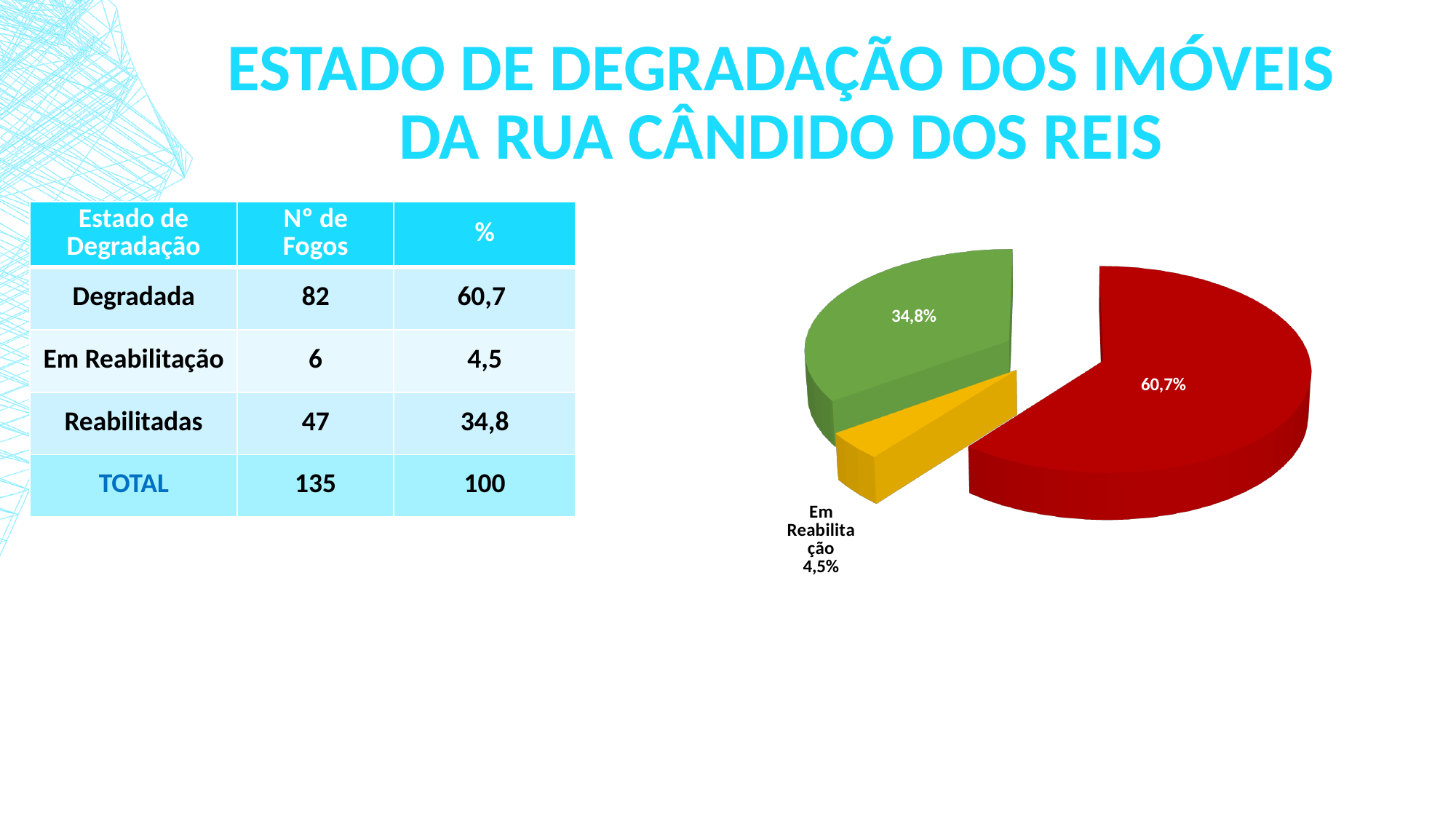
What colour is the Em Reabilitação slice in the pie chart? yellow Which is larger in the pie chart, the green slice or the Em Reabilitação slice? the green slice How many slices does the pie chart have? 3 What percentage is shown on the green slice of the pie chart? 34,8% What is the difference in percentage points between the green slice and the Em Reabilitação slice? 30,3 Which slice of the pie chart is the largest? the red slice (60,7%) What kind of chart is shown on the slide? pie chart Which slice of the pie chart is labelled with a category name on the chart itself? Em Reabilitação What is the difference in percentage points between the red slice and the green slice of the pie chart? 25,9 What percentage does the pie chart show for Em Reabilitação? 4,5% What percentage is shown on the red slice of the pie chart? 60,7% Which slice of the pie chart is the smallest? Em Reabilitação (4,5%)